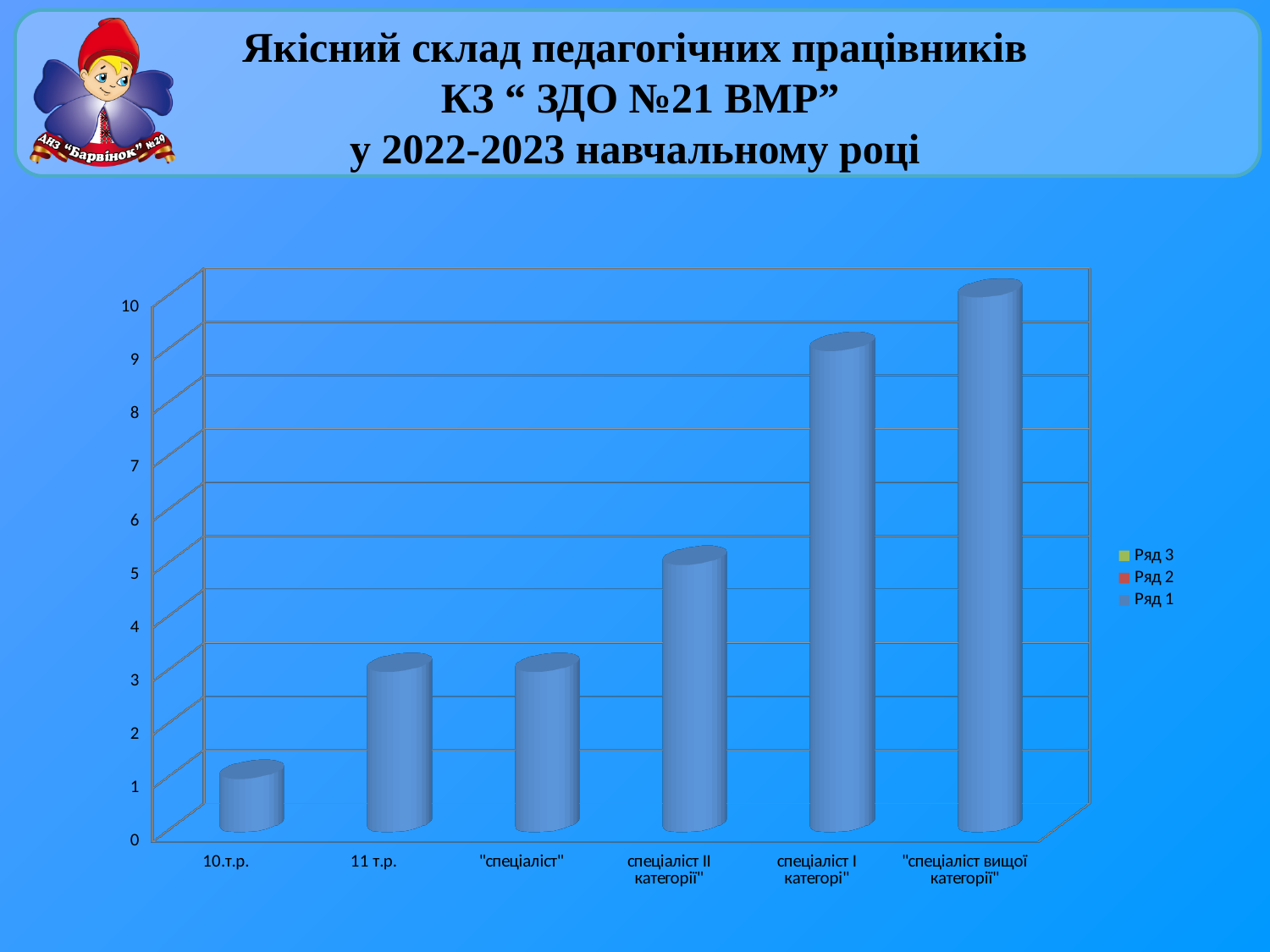
Which is larger, the value for "спеціаліст" or the value for спеціаліст II категорії? спеціаліст II категорії Which category has the highest bar in the chart? "спеціаліст вищої категорії" What is the value for 10.т.р.? 1 Do the bar values generally rise or fall from left to right along the x axis? rise What is the value for "спеціаліст вищої категорії"? 10 What kind of chart is shown on the slide? bar chart Is the value for 11 т.р. greater or less than 4? less How many series does the chart legend list? 3 How many categories are shown on the x axis of the chart? 6 Is the value for спеціаліст II категорії greater or less than 4? greater Is the value for спеціаліст I категорі greater or less than 8? greater Which category has the lowest bar in the chart? 10.т.р.